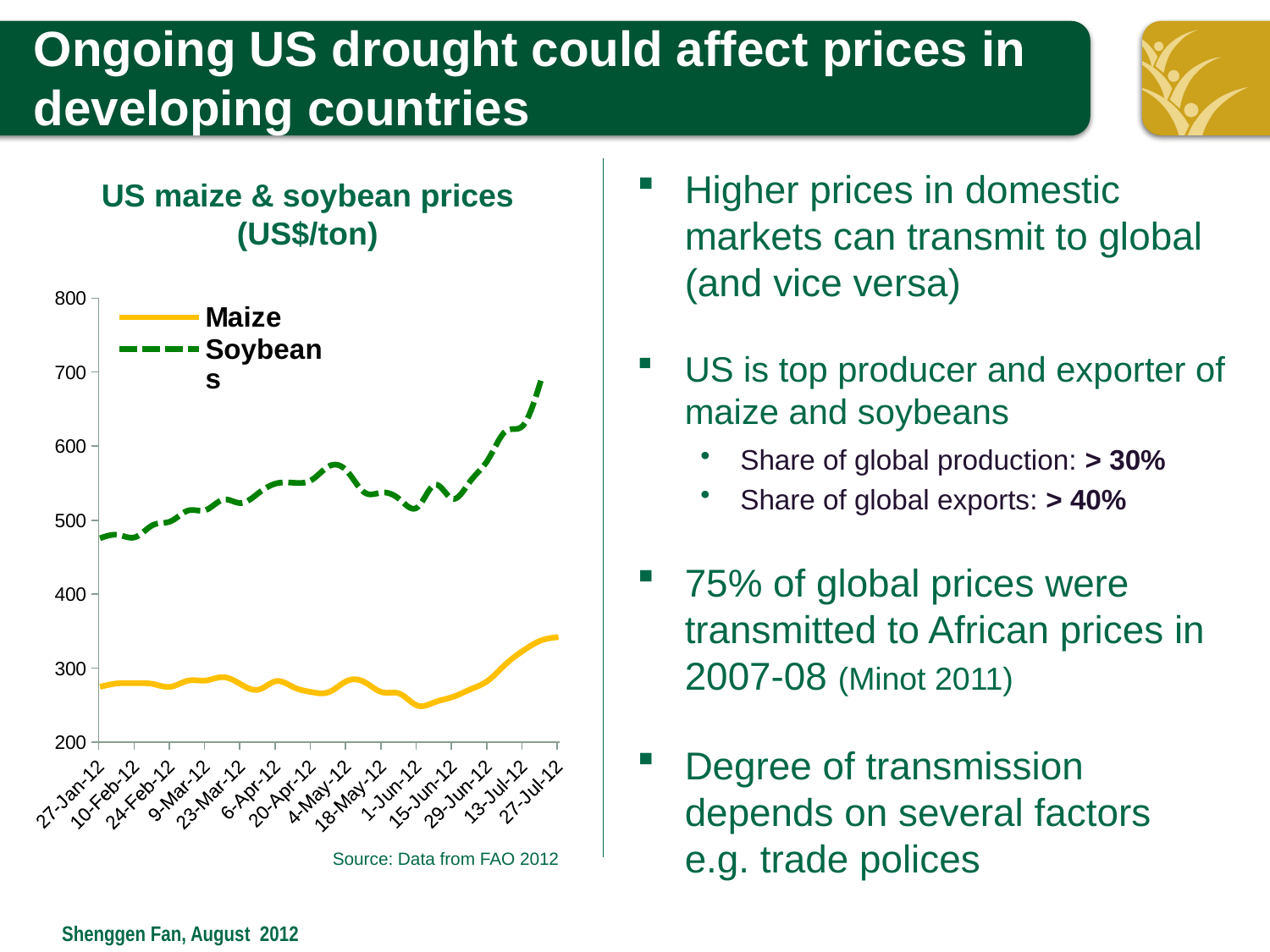
Is the Maize price at 27-Jul-12 greater or less than 300? greater Is the Soybeans price at 27-Jan-12 greater or less than 500? less How many series does the chart legend list? 2 What kind of chart is shown on the slide? Line chart Which series is drawn with a dashed green line? Soybeans Does the Soybeans price rise or fall between 15-Jun-12 and 27-Jul-12? Rise How many date labels are shown on the x axis? 14 What is the title of the chart? US maize & soybean prices (US$/ton) Is the Maize price at 1-Jun-12 greater or less than 300? less